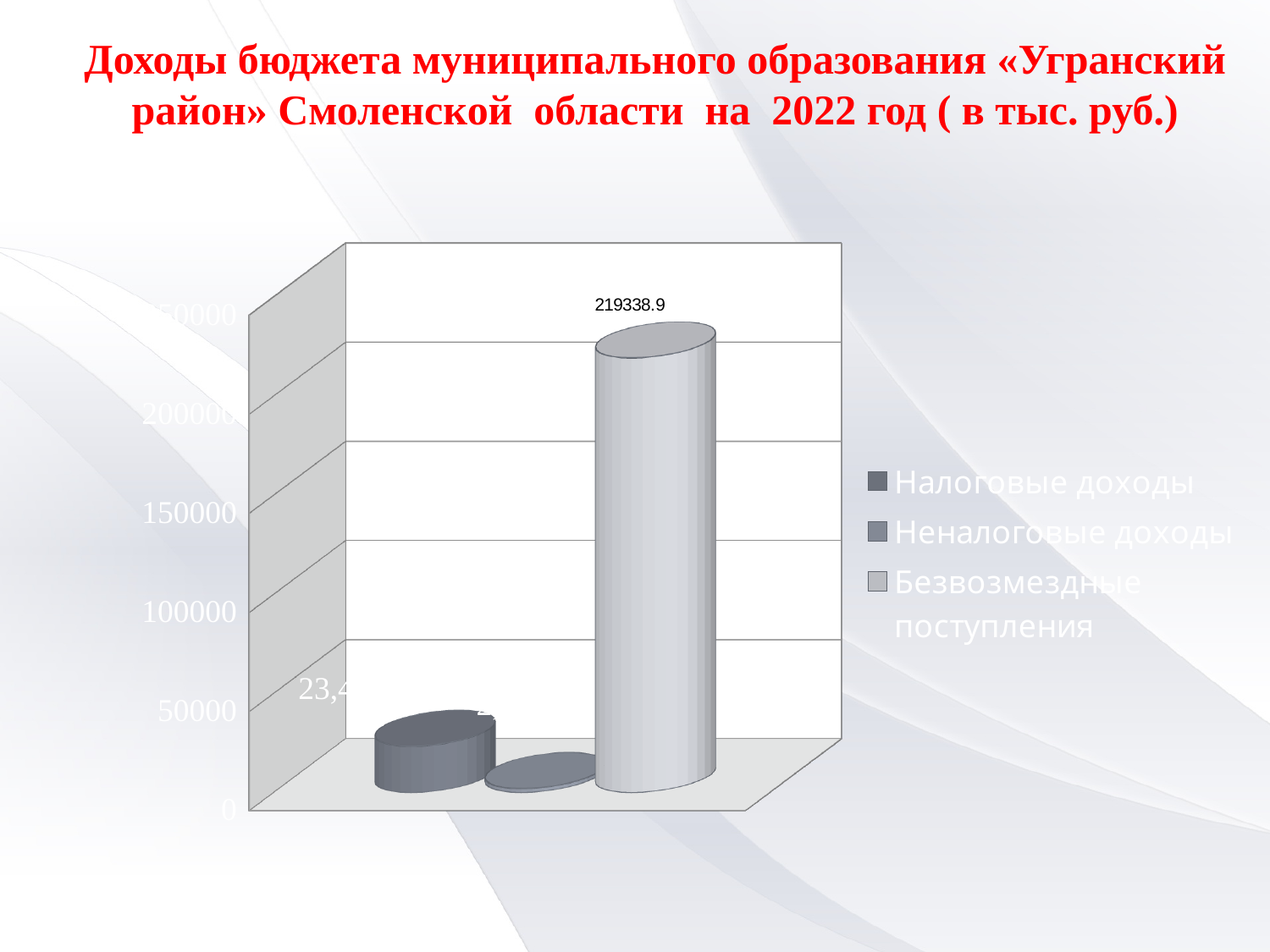
Is the value for Неналоговые доходы greater or less than 50000? less What is the value for Безвозмездные поступления? 219338.9 Which series has the highest value? Безвозмездные поступления Which is larger, Налоговые доходы or Неналоговые доходы? Налоговые доходы What year does the chart title refer to? 2022 Which series has the lowest value? Неналоговые доходы Is the value for Безвозмездные поступления greater or less than 200000? greater How many bars are plotted on the chart? 3 Is the value for Налоговые доходы greater or less than 50000? less How many series does the legend list? 3 What kind of chart is shown on the slide? bar chart In what units are the values given according to the title? тыс. руб.